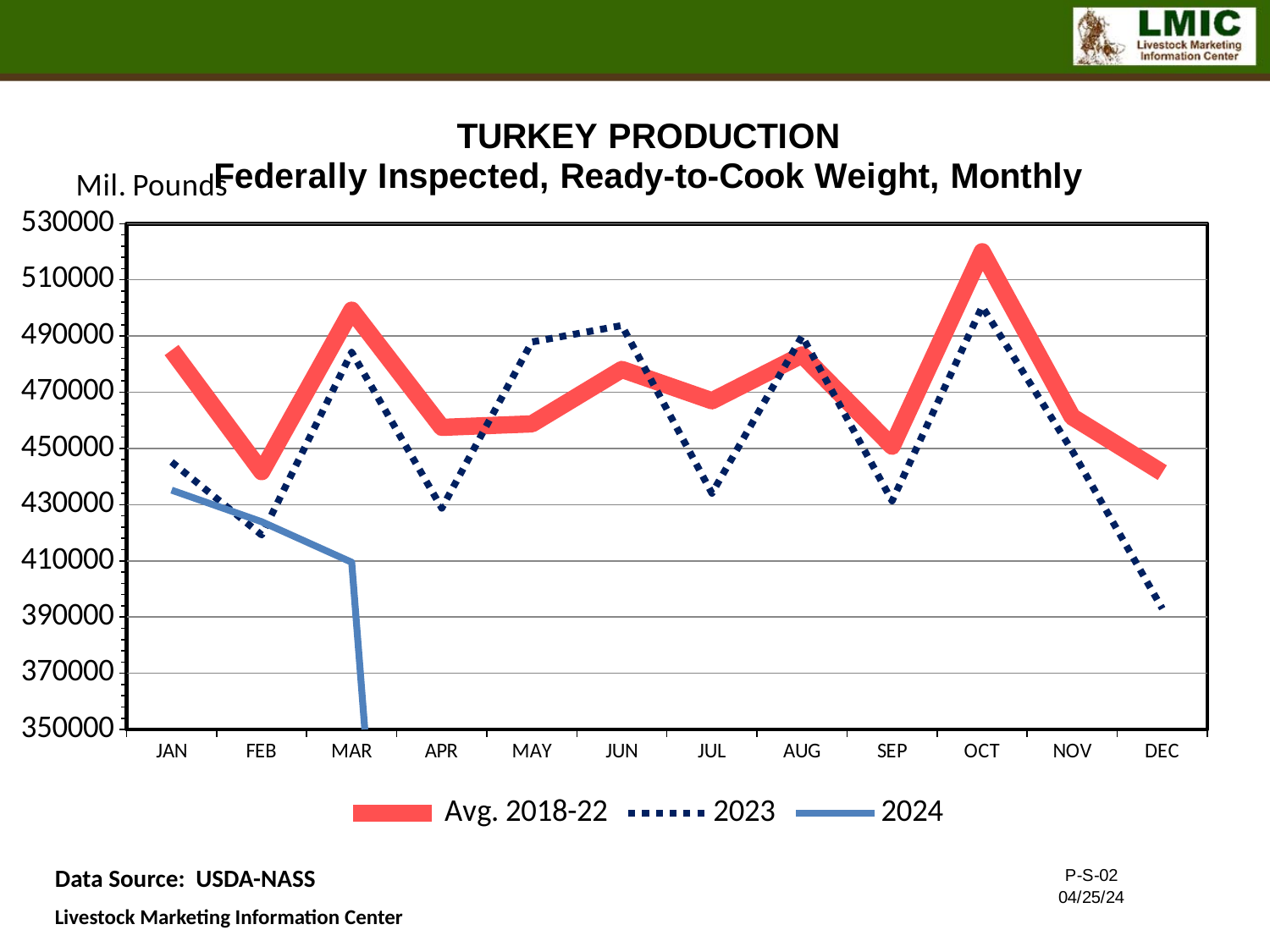
In which month does the Avg. 2018-22 series reach its highest value? OCT How many series does the legend list? 3 What kind of chart is shown on the slide? line chart Is the 2024 value for JAN greater or less than 450000? less In JAN, which series is higher: Avg. 2018-22 or 2023? Avg. 2018-22 How many months are shown along the x axis? 12 Does the 2024 series rise or fall from JAN to MAR? fall Is the Avg. 2018-22 value for OCT greater or less than 510000? greater In which month does the 2023 series reach its lowest value? DEC Is the 2023 value for APR greater or less than 450000? less In MAY, which series is higher: Avg. 2018-22 or 2023? 2023